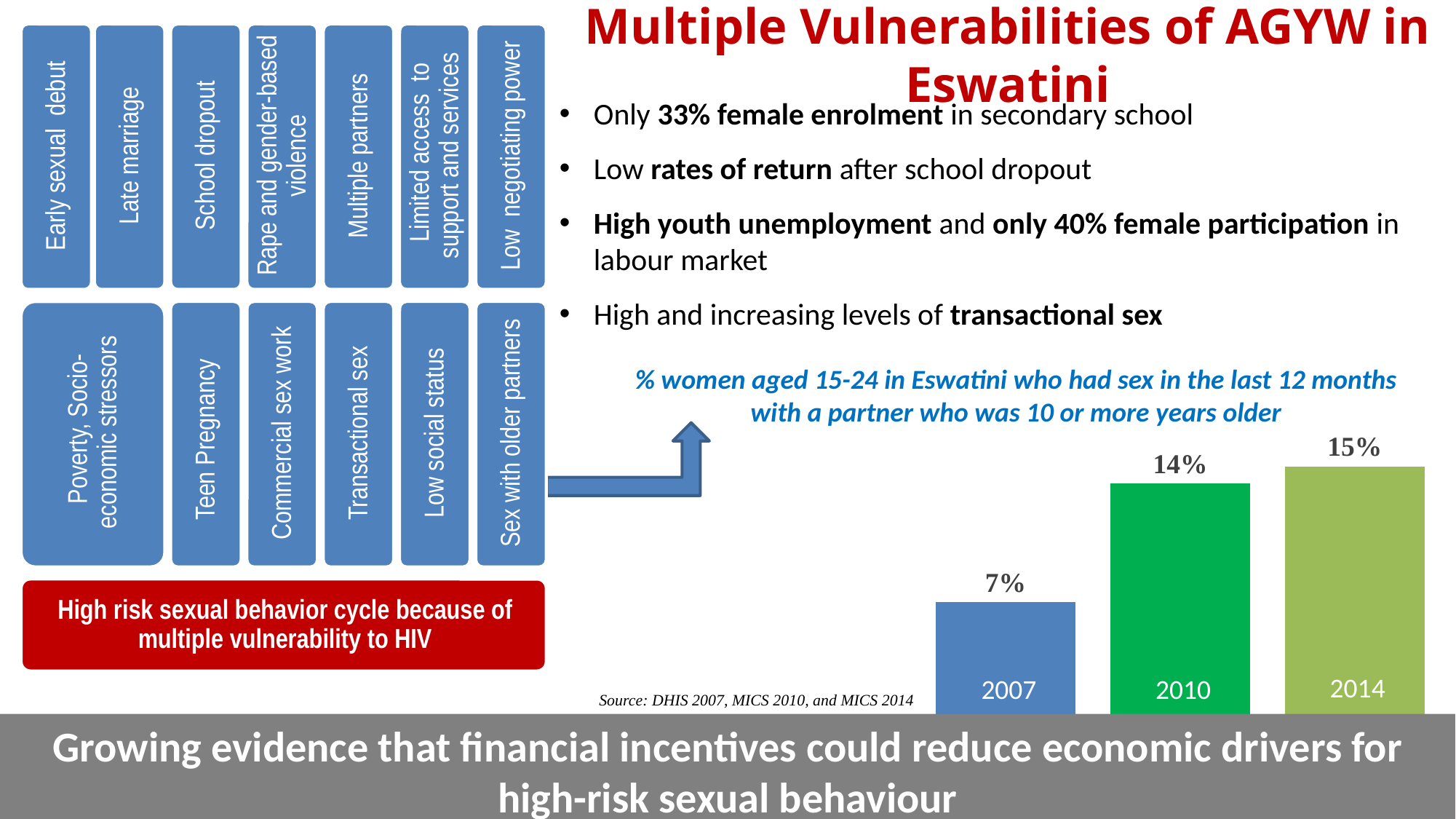
What is the value for 2007 in the bar chart? 7% What is the title of the bar chart? % women aged 15-24 in Eswatini who had sex in the last 12 months with a partner who was 10 or more years older What kind of chart is shown on the slide? bar chart What is the value for 2010 in the bar chart? 14% What is the difference between the values for 2010 and 2007 in the bar chart? 7% Which year has the highest value in the bar chart? 2014 How many years are shown in the bar chart? 3 What is the value for 2014 in the bar chart? 15% What is the difference between the values for 2014 and 2007 in the bar chart? 8% Which is larger in the bar chart, the value for 2007 or the value for 2010? 2010 Which year has the lowest value in the bar chart? 2007 Do the values in the bar chart rise or fall from 2007 to 2014? rise